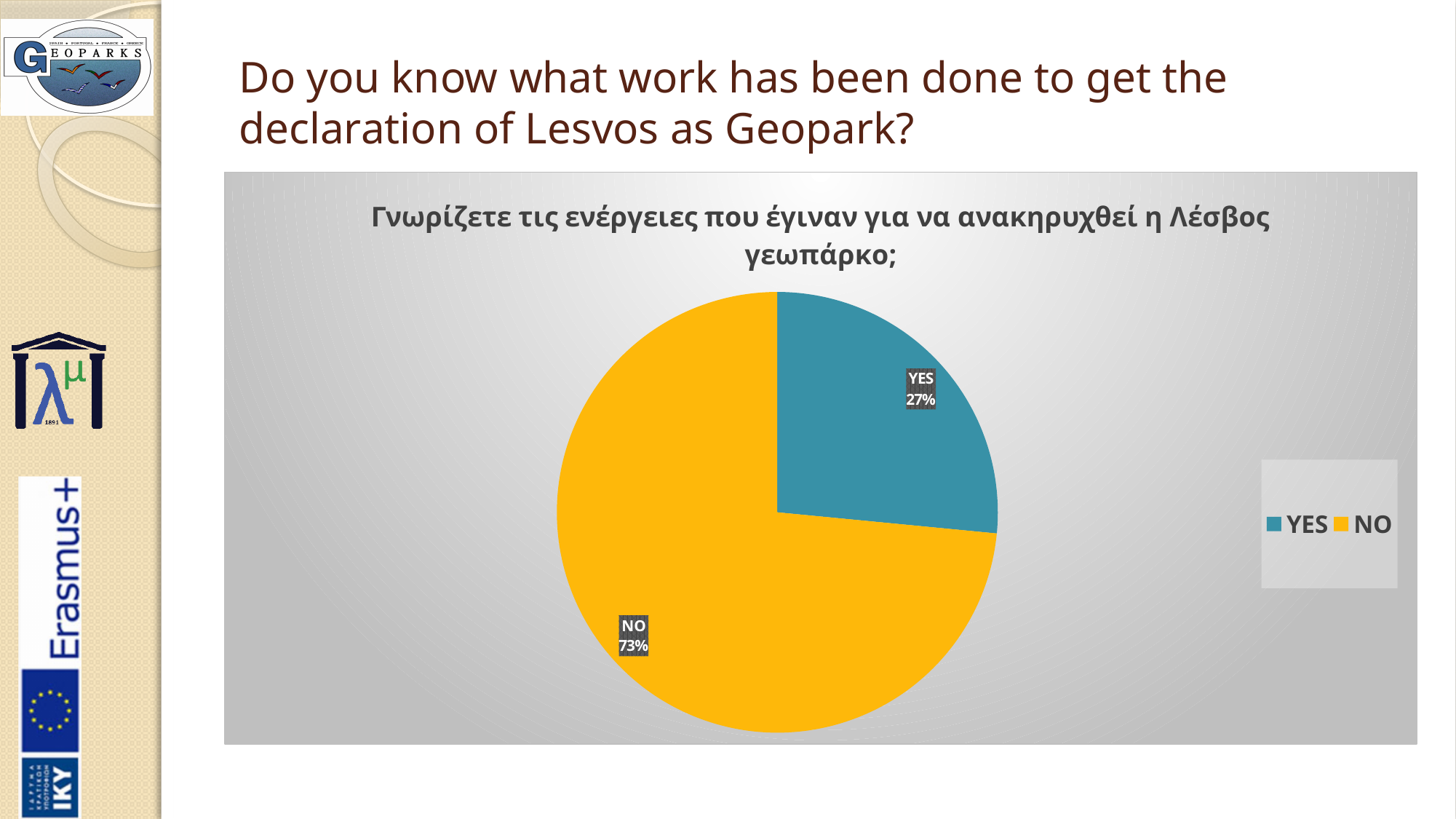
What colour is the YES slice? teal blue Which response has the smallest share of the pie? YES How many slices does the pie chart have? 2 What percentage of respondents answered NO? 73% Which response has the largest share of the pie? NO What colour is the NO slice? yellow/orange How many entries does the legend list? 2 What kind of chart is shown on the slide? pie chart What is the difference in percentage points between the NO and YES shares? 46 What share of the pie does the YES slice represent? 27% Which is larger, the YES share or the NO share? NO What percentage of respondents answered YES? 27%